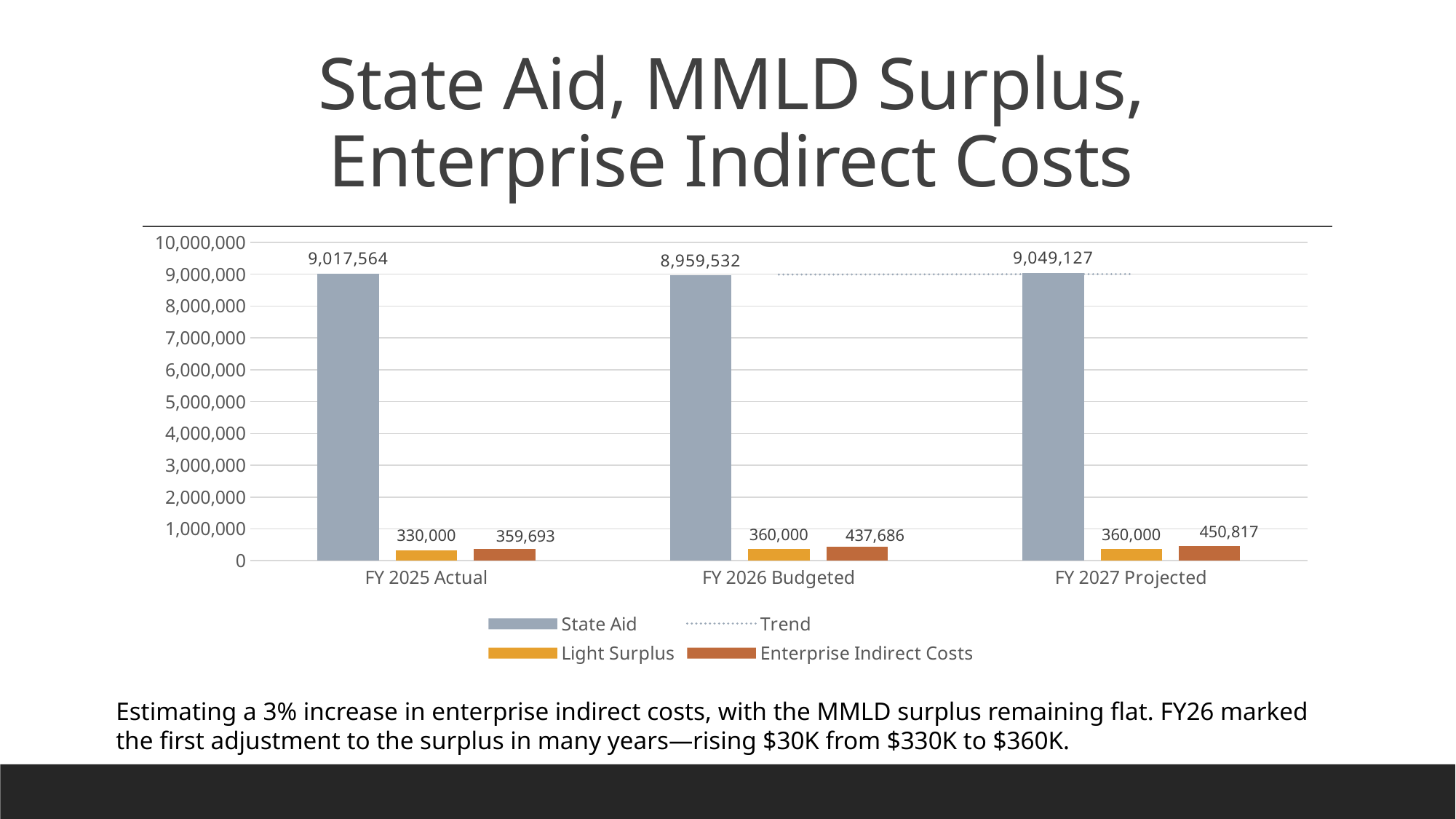
What is the Enterprise Indirect Costs value for FY 2026 Budgeted? 437,686 How many fiscal year categories are shown on the x axis? 3 What is the Light Surplus value for FY 2027 Projected? 360,000 What is the State Aid value for FY 2025 Actual? 9,017,564 Do the Enterprise Indirect Costs values rise or fall from FY 2025 Actual to FY 2027 Projected? Rise In which fiscal year is Enterprise Indirect Costs highest? FY 2027 Projected In which fiscal year is State Aid lowest? FY 2026 Budgeted Which is larger in FY 2025 Actual: Light Surplus or Enterprise Indirect Costs? Enterprise Indirect Costs By how much does Light Surplus increase from FY 2025 Actual to FY 2026 Budgeted? 30,000 How many entries does the legend list? 4 What kind of chart is shown on the slide? Bar chart What is the difference between Enterprise Indirect Costs in FY 2027 Projected and FY 2026 Budgeted? 13,131